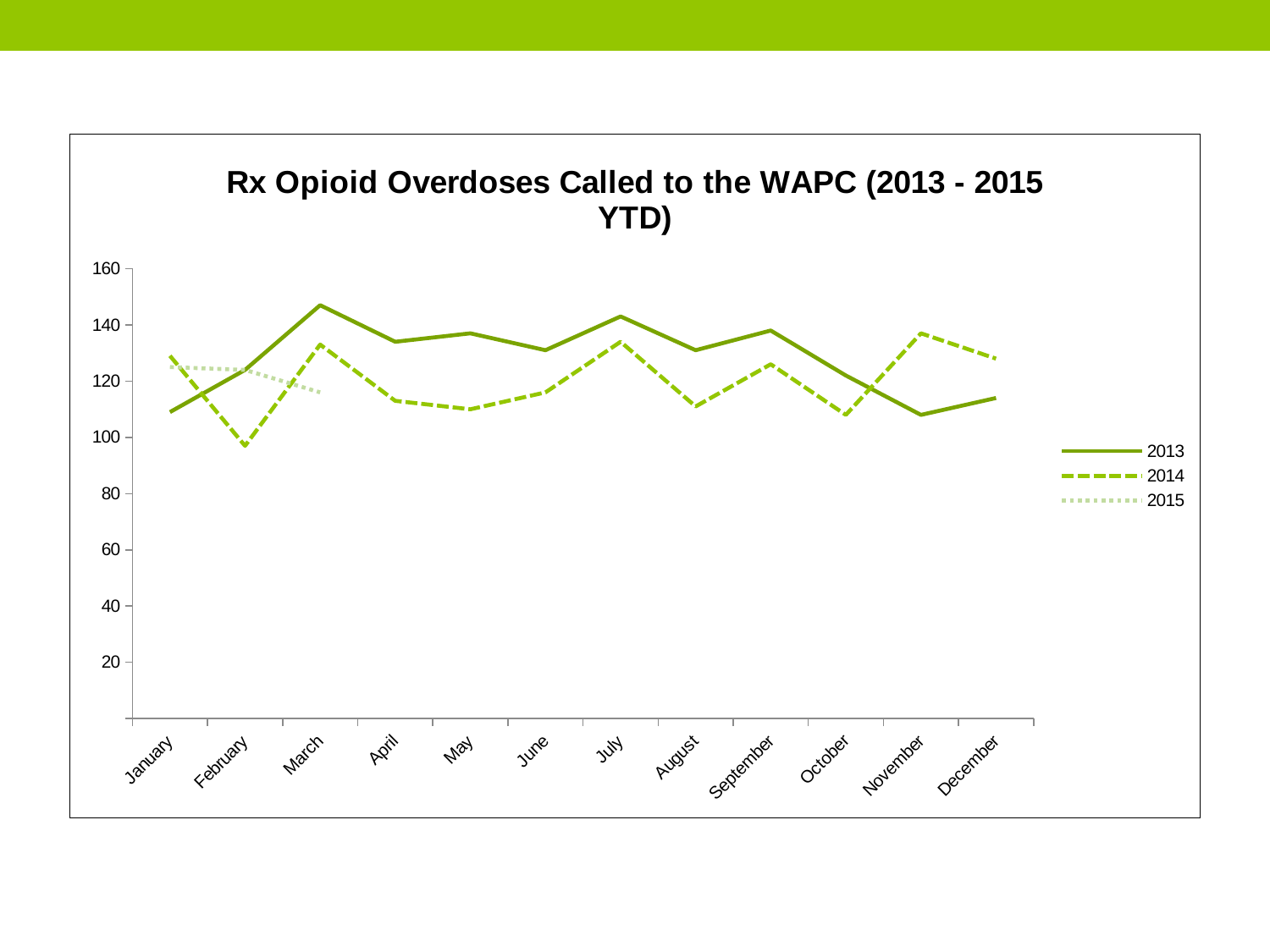
In which month does the 2014 line reach its lowest value? February In which month does the 2013 line reach its highest value? March How many months are shown along the x axis? 12 Is the 2013 value for March greater or less than 140? greater Is the 2014 value for February greater or less than 100? less In November, which series has the higher value, 2013 or 2014? 2014 For how many months does the 2015 series have data plotted? 3 Is the 2013 value for November greater or less than 120? less In January, which series has the higher value, 2013 or 2014? 2014 Does the 2015 line rise or fall from January to March? fall What kind of chart is shown on the slide? line chart How many series does the legend list? 3